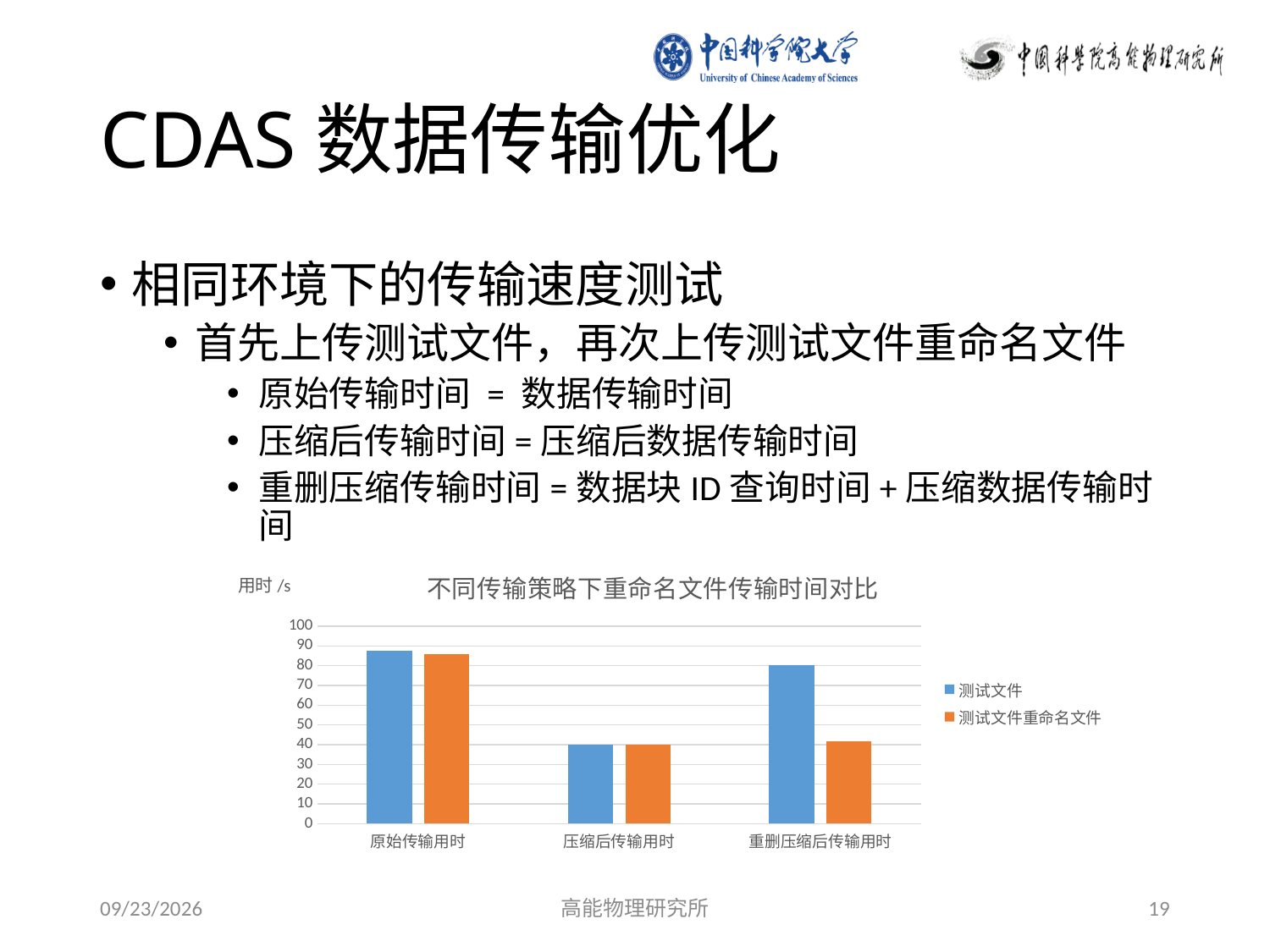
Is the value for 测试文件重命名文件 at 重删压缩后传输用时 greater or less than 50? less How many categories are shown on the x axis of the chart? 3 Is the value for 测试文件 at 压缩后传输用时 greater or less than 50? less Is the value for 测试文件 at 原始传输用时 greater or less than 80? greater At 重删压缩后传输用时, which series has the larger value, 测试文件 or 测试文件重命名文件? 测试文件 What kind of chart is shown on the slide? bar chart How many series does the legend of the chart list? 2 What is the title of the chart? 不同传输策略下重命名文件传输时间对比 What is the label on the vertical axis of the chart? 用时 /s For the 测试文件 series, which category has the lowest value? 压缩后传输用时 For the 测试文件 series, which category has the highest value? 原始传输用时 For the 测试文件重命名文件 series, which category has the highest value? 原始传输用时